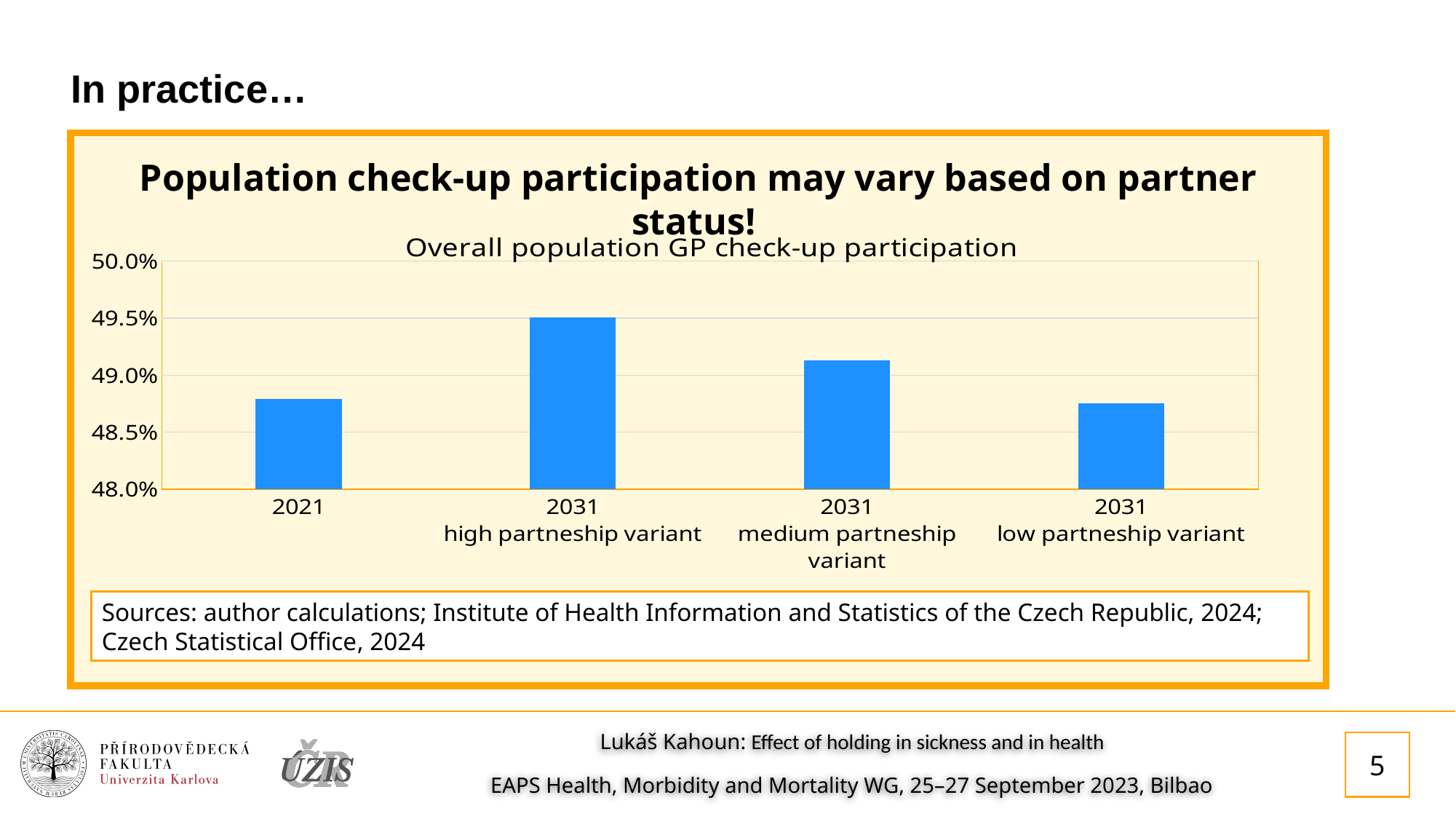
Which is larger: the value for 2031 medium partneship variant or 2021? 2031 medium partneship variant How many bars (categories) does the chart show? 4 Which category has the highest GP check-up participation? 2031 high partneship variant What kind of chart is shown on the slide? bar chart Is the value for 2031 low partneship variant greater or less than 49.0%? less Is the value for 2031 high partneship variant greater or less than 49.0%? greater What is the lowest value shown on the vertical axis of the chart? 48.0% Is the value for 2021 greater or less than 48.5%? greater What is the title of the chart? Overall population GP check-up participation Which is larger: the value for 2031 high partneship variant or 2031 medium partneship variant? 2031 high partneship variant